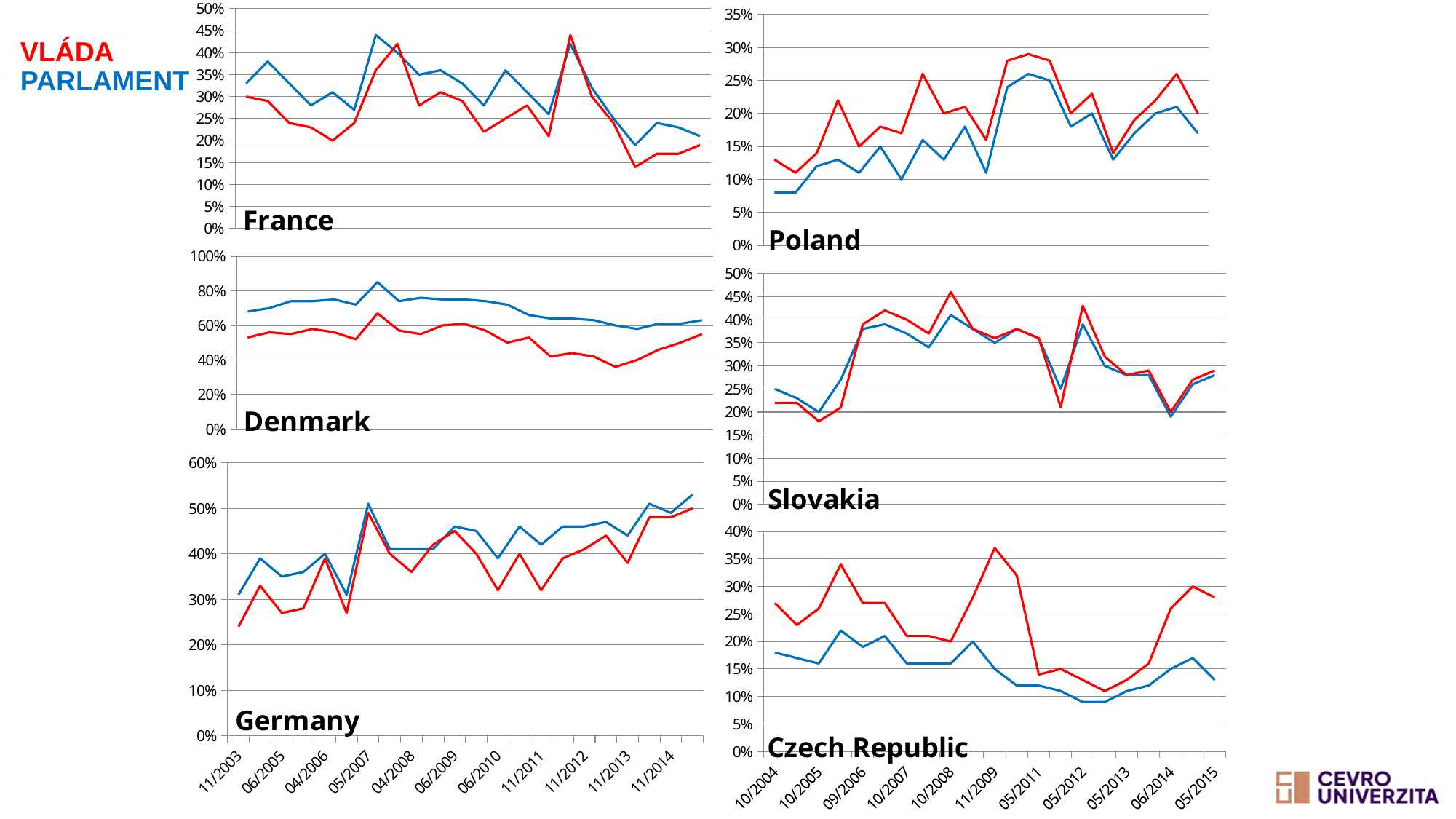
How many series does the legend list? 2 In the Denmark chart, is the first value of the PARLAMENT line greater or less than 60%? greater What kind of chart is the France chart? line chart In the Czech Republic chart, which series has the higher values, VLÁDA or PARLAMENT? VLÁDA In the France chart, is the highest value of the PARLAMENT line greater or less than 40%? greater How many country charts are shown on the slide? 6 In the Germany chart, does the PARLAMENT line overall rise or fall from 11/2003 to the last point? rise In the Poland chart, is the highest value of the VLÁDA line greater or less than 25%? greater What colour is the VLÁDA line in the charts? red In the Denmark chart, which series has the higher values, VLÁDA or PARLAMENT? PARLAMENT